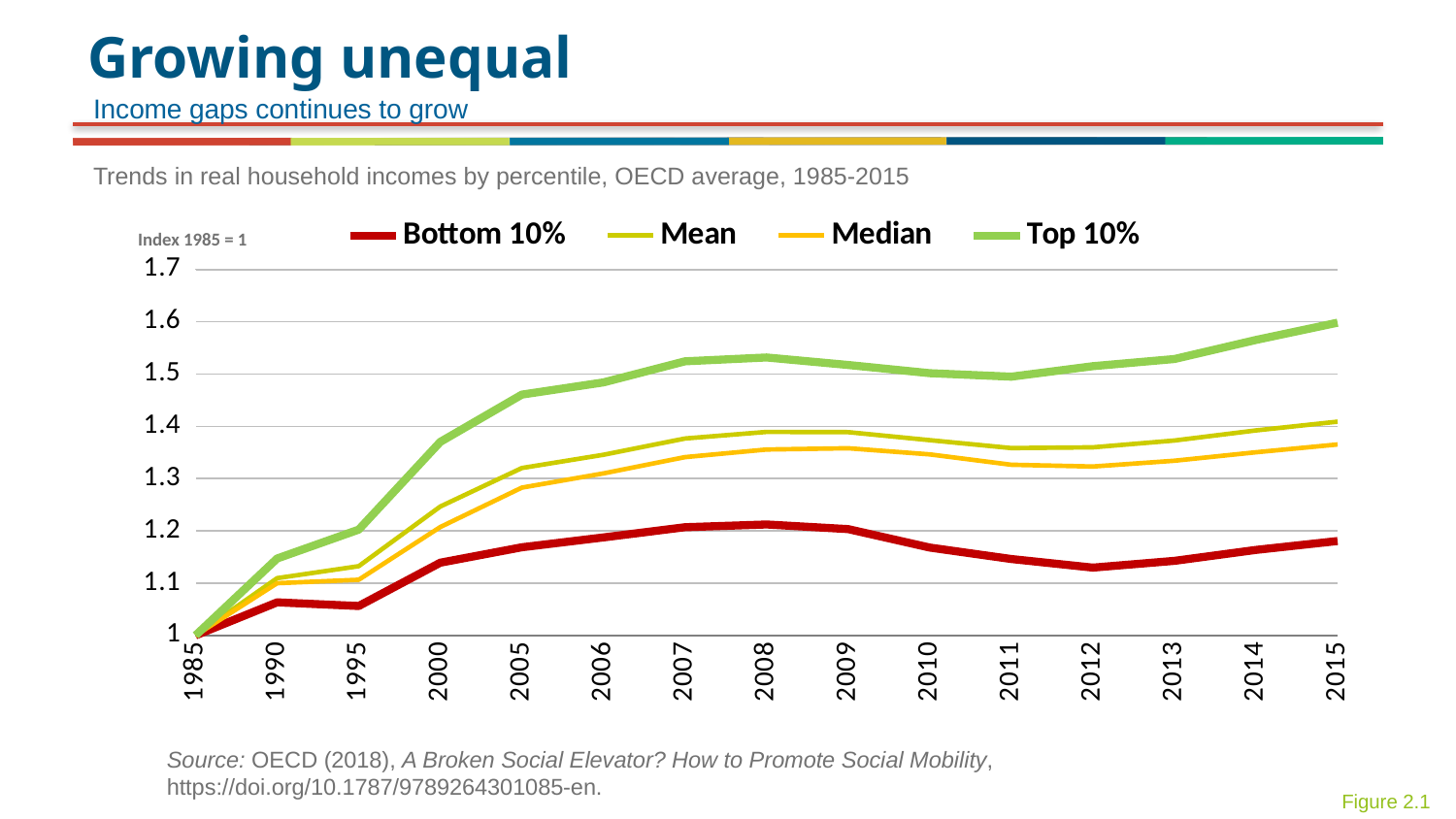
Does the Top 10% series rise or fall overall from 1985 to 2015? Rise Is the value for Bottom 10% in 2015 greater or less than 1.2? less In 2015, which is larger, the Mean or the Median? Mean What kind of chart is shown on the slide? Line chart What is the value of all series in 1985? 1 Is the value for Top 10% in 2005 greater or less than 1.4? greater Which series has the lowest value in 2015? Bottom 10% How many series does the legend list? 4 How many years are labelled along the x axis? 15 Is the value for Median in 2015 greater or less than 1.3? greater What is the chart's title? Trends in real household incomes by percentile, OECD average, 1985-2015 Which series has the highest value in 2015? Top 10%